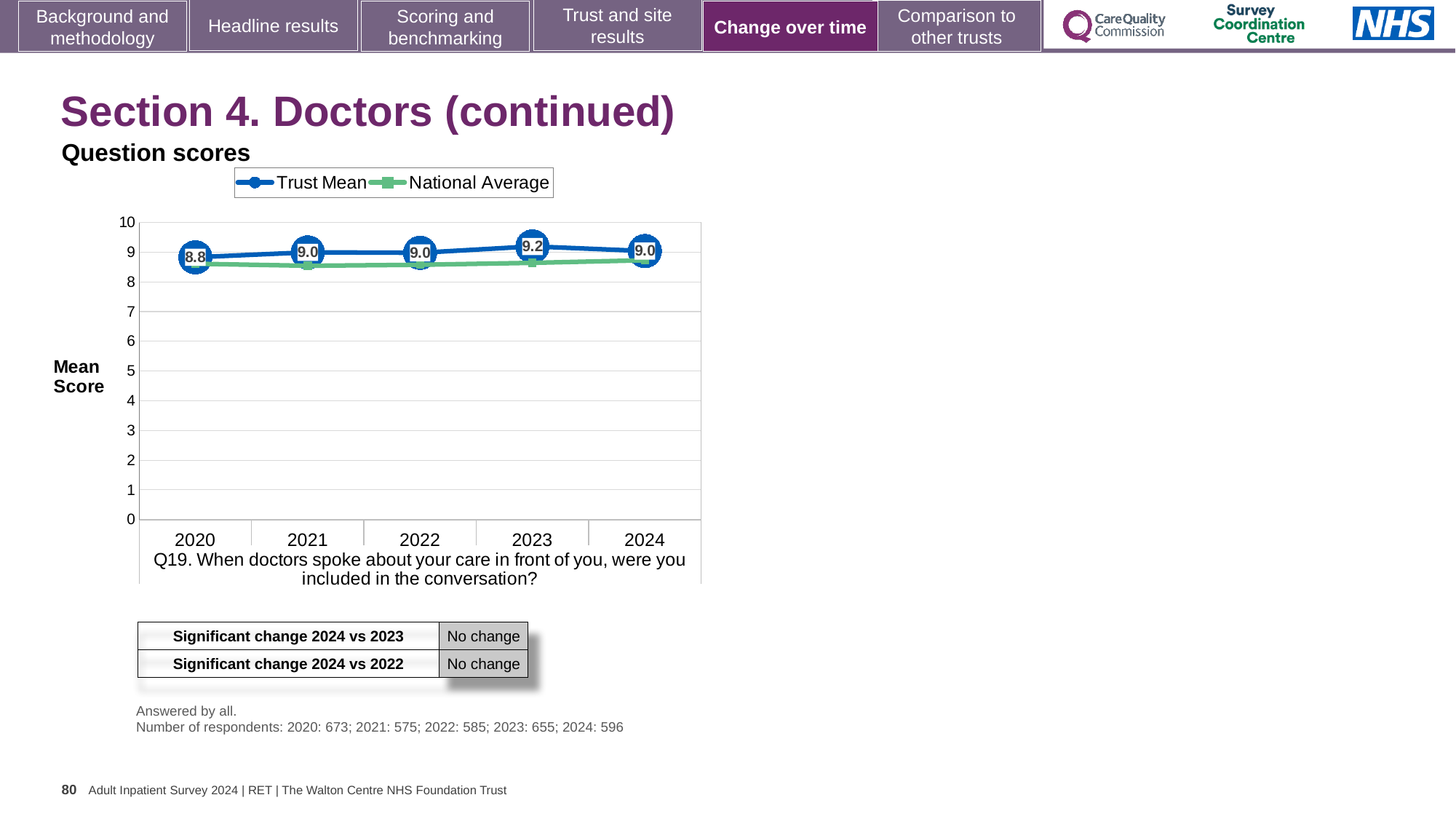
Is the National Average value for 2024 greater or less than 8? greater Does the Trust Mean score rise or fall from 2020 to 2023? Rise What kind of chart is shown on the slide? Line chart How many series does the legend list? 2 What is the Trust Mean score for 2020? 8.8 What is the Trust Mean score for 2023? 9.2 How many years are shown on the x axis? 5 What is the difference between the Trust Mean score in 2023 and in 2020? 0.4 In which year is the Trust Mean score lowest? 2020 What is the Trust Mean score for 2024? 9.0 In which year is the Trust Mean score highest? 2023 Which is larger, the Trust Mean score in 2023 or in 2024? 2023